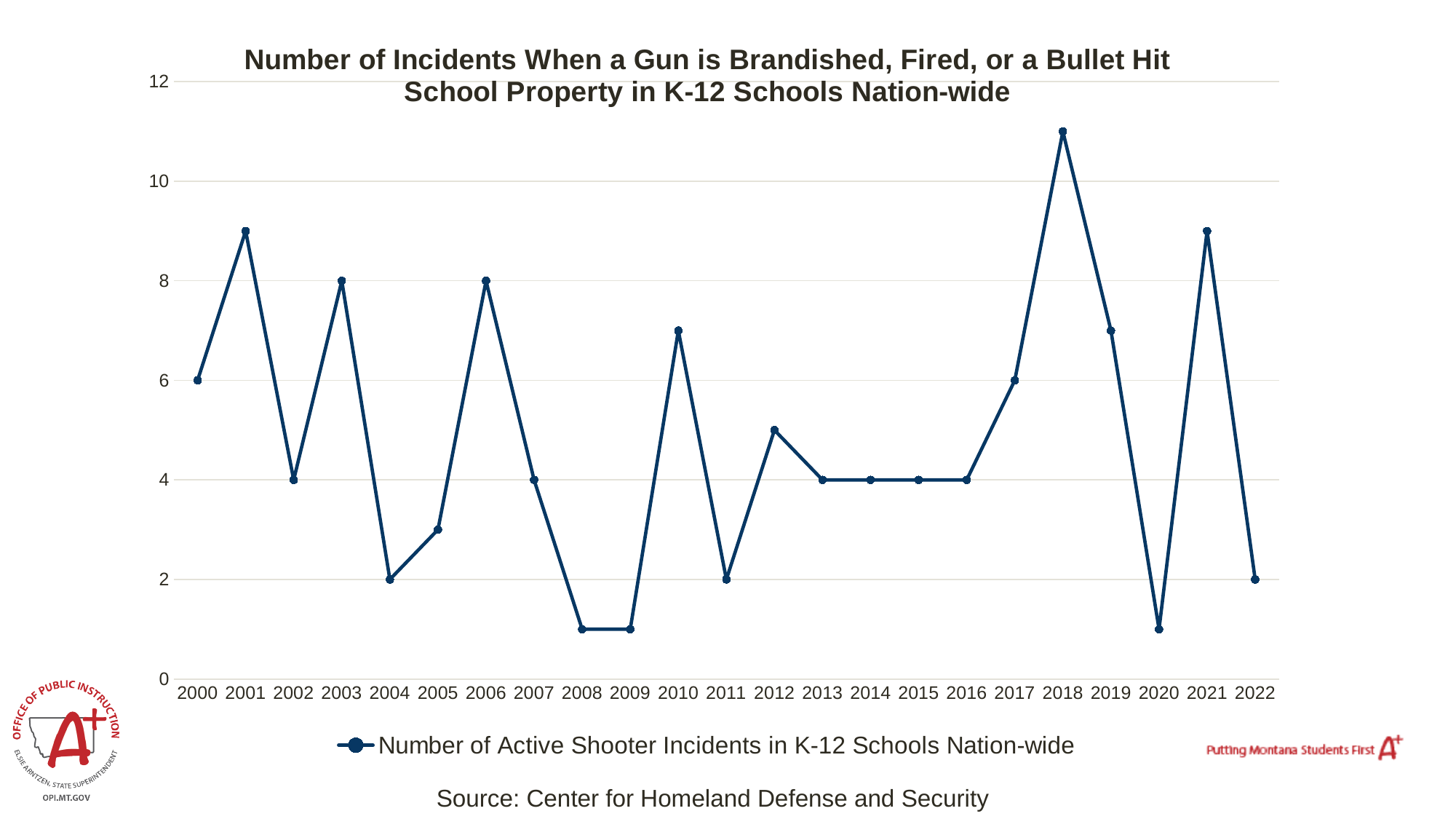
What is the difference between the number of incidents in 2006 and in 2004? 6 Which year has the highest number of incidents? 2018 What is the number of incidents in 2006? 8 How many years are plotted on the x axis? 23 What type of chart is shown on the slide? line chart How many series does the legend list? 1 What is the number of incidents in 2000? 6 What is the source cited below the chart? Center for Homeland Defense and Security What is the number of incidents in 2004? 2 Is the value for 2018 greater or less than 10? greater Which year has more incidents, 2001 or 2002? 2001 Is the value for 2020 greater or less than 2? less